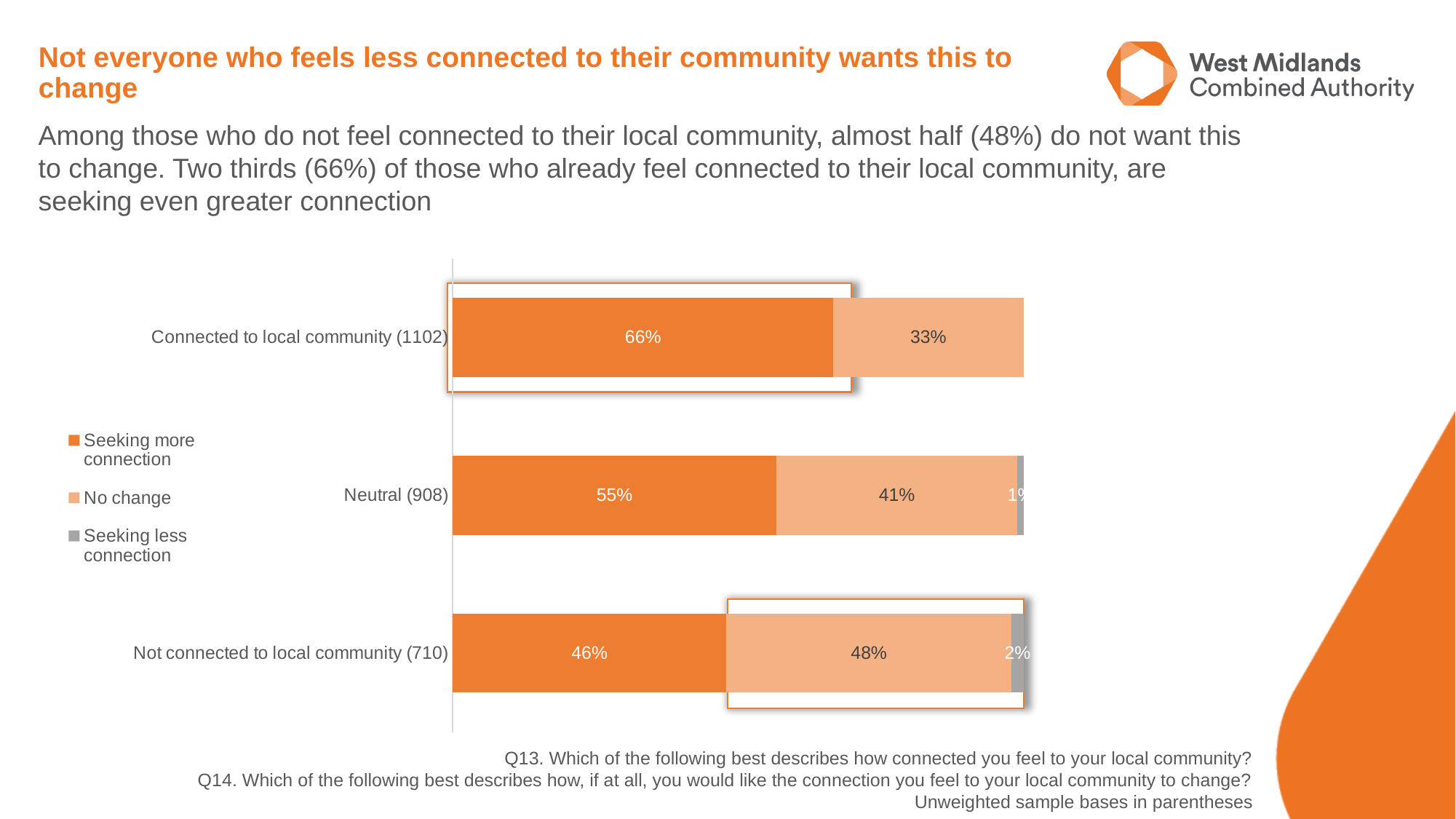
What is the unweighted sample base for the Neutral group? 908 What is the 'No change' value for the Neutral group? 41% Which group has the lowest share seeking more connection? Not connected to local community (710) What type of chart is shown on the slide? Stacked bar chart What is the difference between the 'Seeking more connection' values for the Connected and Not connected groups? 20 percentage points For the Neutral group, which is larger: 'Seeking more connection' or 'No change'? Seeking more connection How many series does the legend list? 3 What percentage of those connected to their local community are seeking more connection? 66% What percentage of those not connected to their local community are seeking less connection? 2% Which group has the highest share seeking more connection? Connected to local community (1102) How many groups (categories) are shown in the chart? 3 What is the 'No change' value for those not connected to their local community? 48%